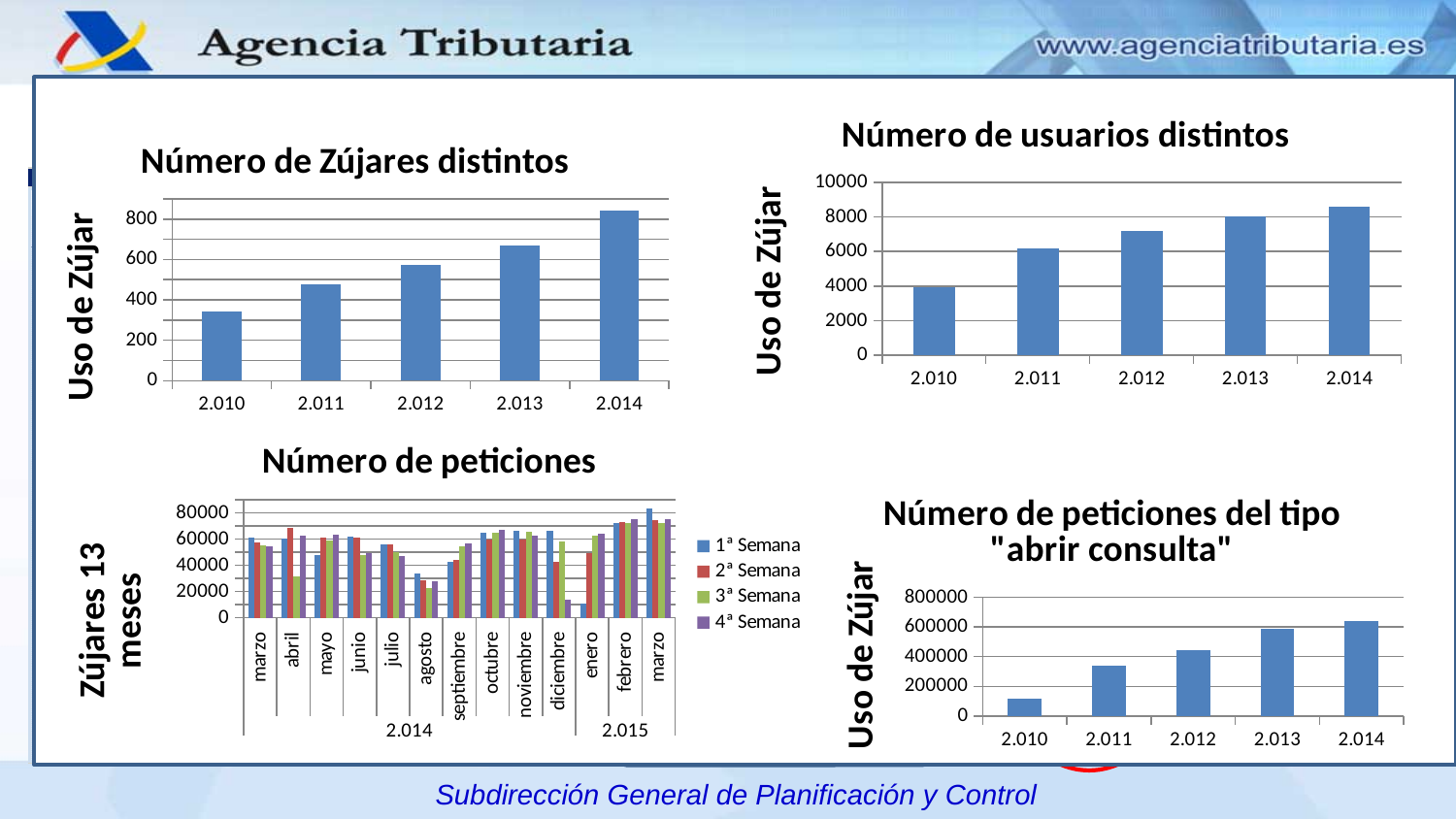
In the 'Número de Zújares distintos' chart, is the value for 2.014 greater or less than 800? greater What kind of chart is the 'Número de peticiones del tipo "abrir consulta"' chart? bar chart In the 'Número de peticiones' chart, which month has the lowest value for 1ª Semana? enero In the 'Número de Zújares distintos' chart, is the value for 2.010 greater or less than 400? less In the 'Número de Zújares distintos' chart, which year has the highest value? 2.014 How many months are shown on the x axis of the 'Número de peticiones' chart? 13 In the 'Número de usuarios distintos' chart, is the value for 2.011 greater or less than 6000? greater In the 'Número de usuarios distintos' chart, which year has the lowest value? 2.010 In the 'Número de usuarios distintos' chart, do the values rise or fall from 2.010 to 2.014? rise In the 'Número de peticiones del tipo "abrir consulta"' chart, which is larger, the value for 2.012 or the value for 2.013? 2.013 How many series does the legend of the 'Número de peticiones' chart list? 4